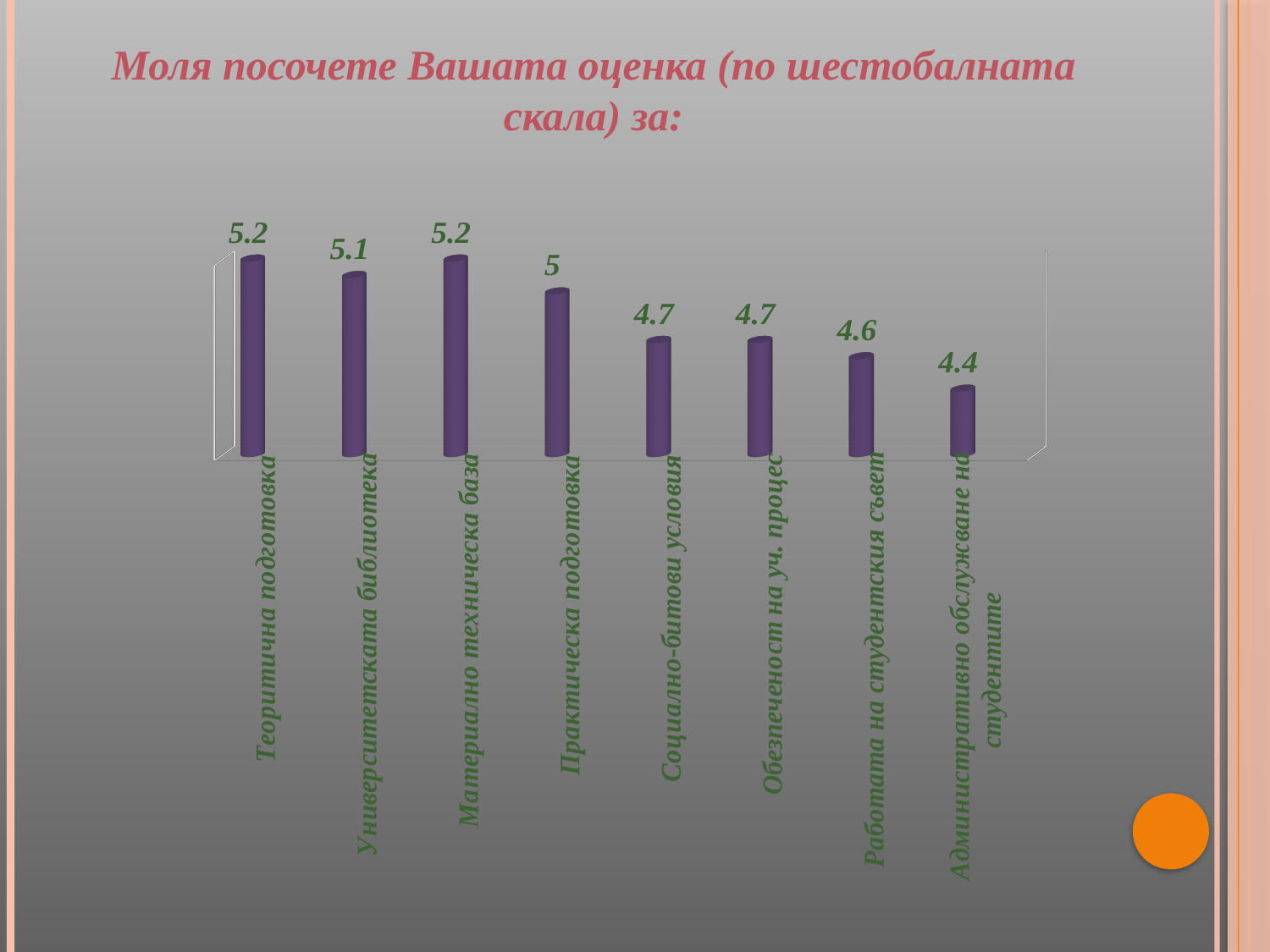
What kind of chart is shown on the slide? Bar chart What is the difference between the values for Практическа подготовка and Социално-битови условия? 0.3 Which is larger, the value for Университетската библиотека or the value for Работата на студентския съвет? Университетската библиотека How many categories are shown in the chart? 8 What is the difference between the values for Теоритична подготовка and Административно обслужване на студентите? 0.8 Do the values generally rise or fall from left to right along the x axis? Fall What is the value for Административно обслужване на студентите? 4.4 What is the value for Работата на студентския съвет? 4.6 Which category has the lowest value? Административно обслужване на студентите What is the value for Теоритична подготовка? 5.2 What is the value for Университетската библиотека? 5.1 What is the value for Практическа подготовка? 5